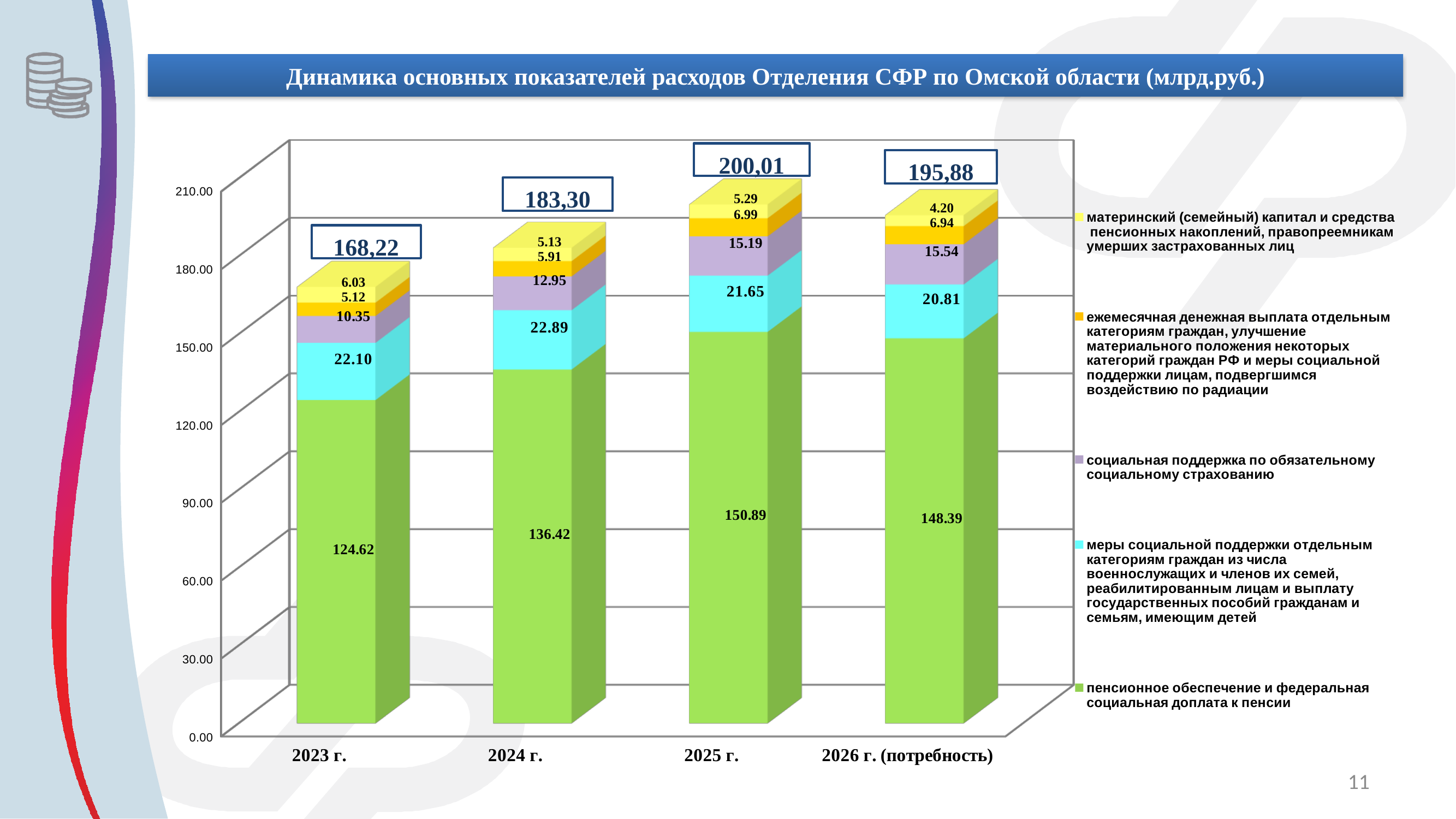
What is the value of ежемесячная денежная выплата отдельным категориям граждан for 2025 г.? 6.99 What is the value of пенсионное обеспечение и федеральная социальная доплата к пенсии for 2023 г.? 124.62 Which year has the lowest total expenditure? 2023 г. What is the value of социальная поддержка по обязательному социальному страхованию for 2026 г. (потребность)? 15.54 Which is larger: the меры социальной поддержки (cyan) segment in 2023 г. or in 2024 г.? 2024 г. What is the difference between the pension segment (пенсионное обеспечение) in 2025 г. and 2024 г.? 14.47 Which year has the highest total expenditure? 2025 г. How many series does the legend list? 5 What is the total of the stacked bar for 2024 г.? 183,30 What is the value of пенсионное обеспечение и федеральная социальная доплата к пенсии for 2025 г.? 150.89 How many years (categories) are shown on the x axis? 4 What kind of chart is shown on the slide? Stacked bar chart